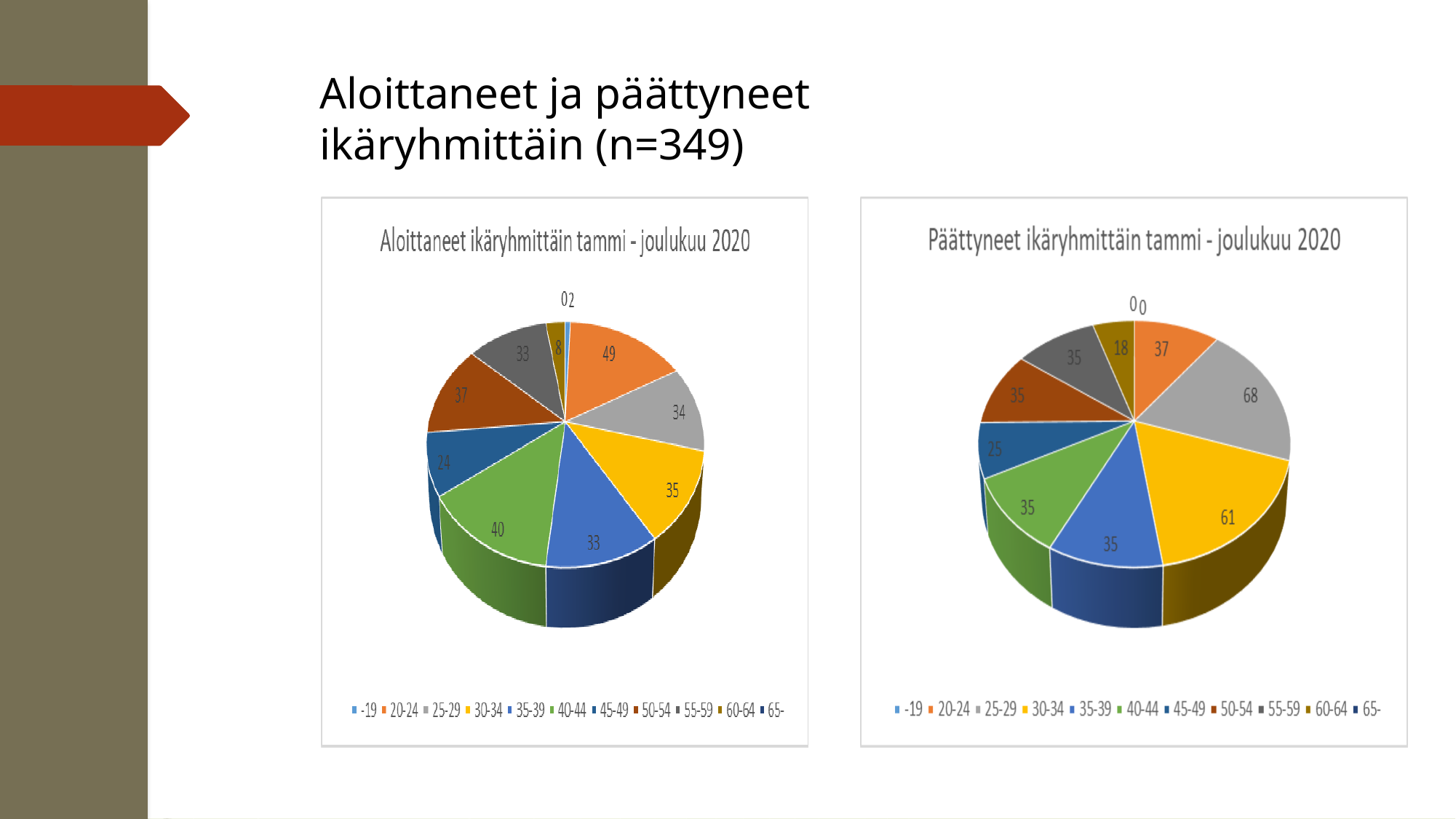
In the left chart 'Aloittaneet ikäryhmittäin tammi - joulukuu 2020', which age group has the highest value? 20-24 In the right chart 'Päättyneet ikäryhmittäin tammi - joulukuu 2020', what is the difference between the values for 30-34 and 45-49? 36 In the left chart 'Aloittaneet ikäryhmittäin tammi - joulukuu 2020', what is the value for the 40-44 age group? 40 In the left chart 'Aloittaneet ikäryhmittäin tammi - joulukuu 2020', which is larger: the value for 30-34 or the value for 60-64? 30-34 How many age groups does the legend of the right chart 'Päättyneet ikäryhmittäin tammi - joulukuu 2020' list? 11 In the right chart 'Päättyneet ikäryhmittäin tammi - joulukuu 2020', what is the value for the 60-64 age group? 18 In the right chart 'Päättyneet ikäryhmittäin tammi - joulukuu 2020', what is the value for the 25-29 age group? 68 In the left chart 'Aloittaneet ikäryhmittäin tammi - joulukuu 2020', what is the value for the 20-24 age group? 49 In the right chart 'Päättyneet ikäryhmittäin tammi - joulukuu 2020', which is larger: the value for 20-24 or the value for 30-34? 30-34 In the left chart 'Aloittaneet ikäryhmittäin tammi - joulukuu 2020', what is the difference between the values for 50-54 and 45-49? 13 What type of chart is used on the left chart, 'Aloittaneet ikäryhmittäin tammi - joulukuu 2020'? Pie chart In the right chart 'Päättyneet ikäryhmittäin tammi - joulukuu 2020', which age group has the highest value? 25-29